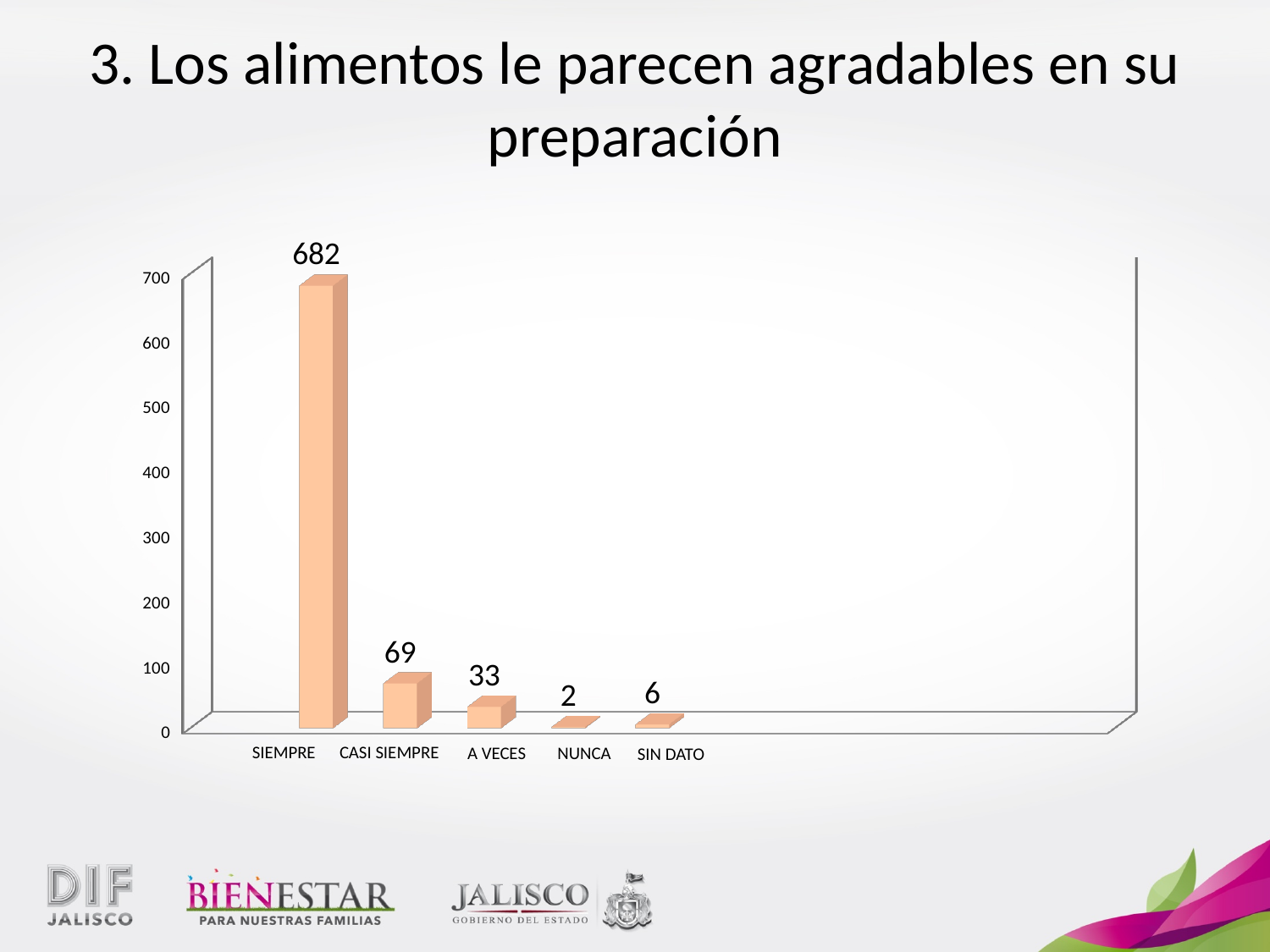
How many categories are shown on the x axis? 5 Which category has the highest value? SIEMPRE What kind of chart is shown on the slide? Bar chart What is the title of the slide? 3. Los alimentos le parecen agradables en su preparación What is the value for NUNCA? 2 What is the value for SIEMPRE? 682 What is the value for A VECES? 33 What is the value for CASI SIEMPRE? 69 Which category has the lowest value? NUNCA What is the difference between the values for SIEMPRE and CASI SIEMPRE? 613 What is the value for SIN DATO? 6 Which is larger, the value for A VECES or the value for SIN DATO? A VECES